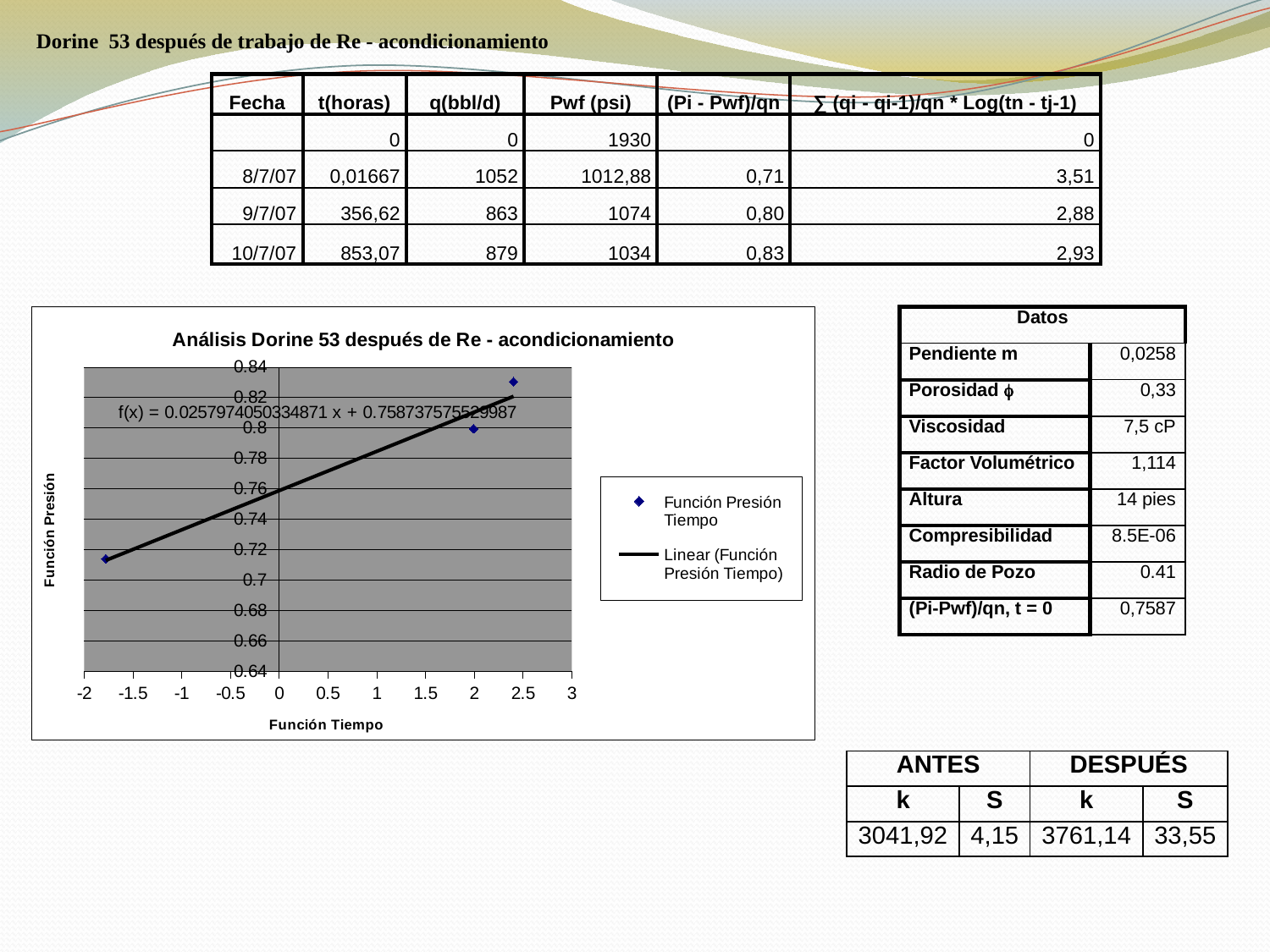
Is the Función Presión value of the rightmost data point (near x = 2.5) greater or less than 0.8? greater What is the title of the chart? Análisis Dorine 53 después de Re - acondicionamiento What is the slope of the linear trendline equation printed on the chart? 0.0257974050334871 How many entries does the chart legend list? 2 How many data points are plotted in the 'Función Presión Tiempo' series? 3 Do the plotted values rise or fall as Función Tiempo increases along the x axis? rise What kind of chart is shown on the slide? scatter chart with a linear trendline Is the Función Presión value of the leftmost data point (near x = -1.75) greater or less than 0.74? less Which data point has the lowest Función Presión value? the leftmost point, near x = -1.75 Is the Función Presión value of the data point at x = 2 greater or less than 0.78? greater What is the label of the x axis of the chart? Función Tiempo Which data point has the highest Función Presión value? the rightmost point, near x = 2.5